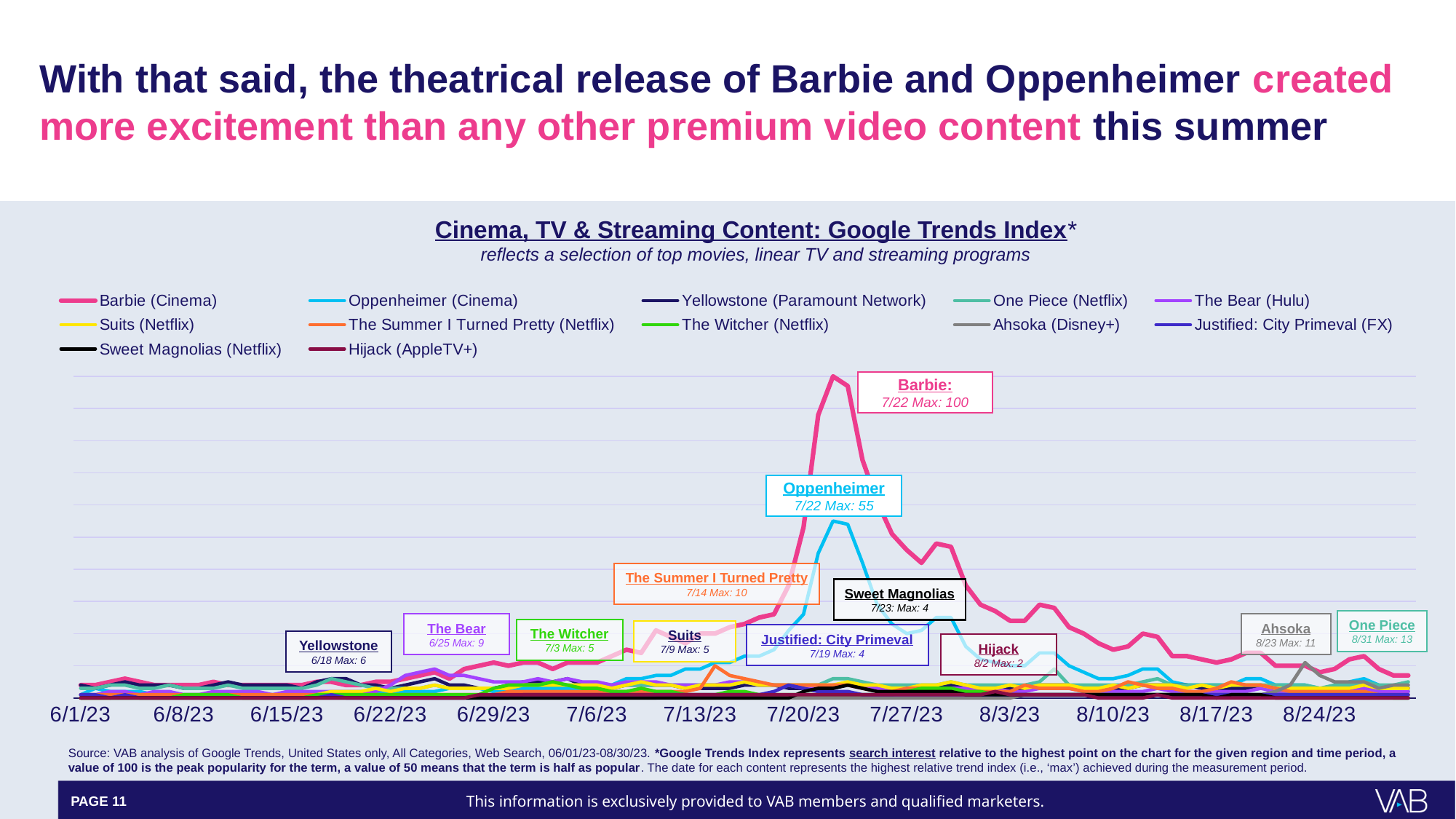
What is the difference between the annotated maximum values of Barbie and Oppenheimer? 45 What is the maximum index value annotated for The Summer I Turned Pretty? 10 How many series does the legend list? 12 What is the maximum index value annotated for One Piece? 13 What is the difference between the annotated maximum values of The Bear and Yellowstone? 3 Which series reaches the highest peak on the chart? Barbie (Cinema) What is the maximum Google Trends Index value reached by Barbie (Cinema), according to the annotation? 100 What is the title of the chart? Cinema, TV & Streaming Content: Google Trends Index On what date did Oppenheimer reach its maximum index value? 7/22 Which has a higher annotated maximum index value, Ahsoka or One Piece? One Piece What type of chart is shown on the slide? Line chart Which annotated series has the lowest maximum index value? Hijack